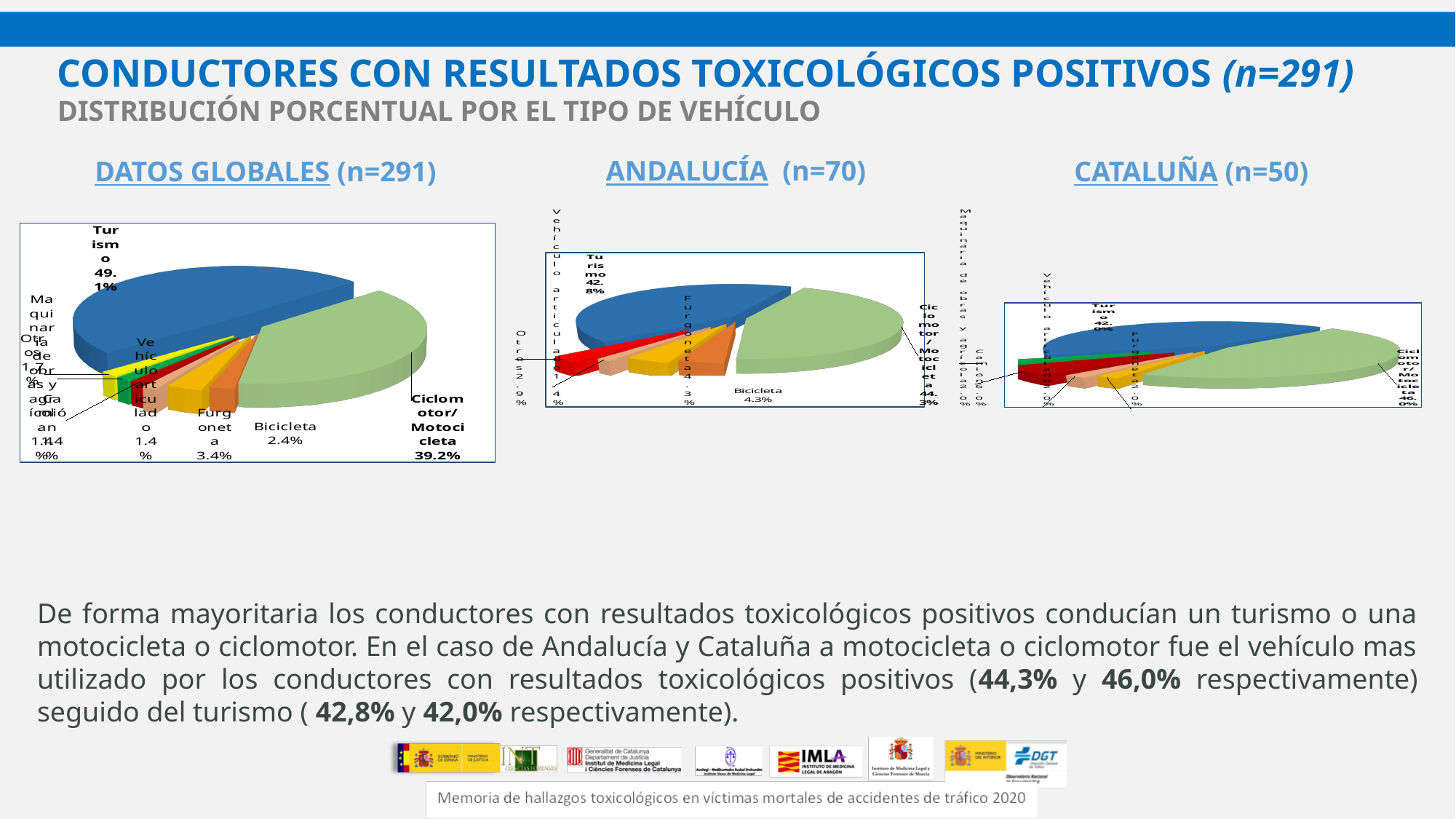
In the Andalucía chart, which is larger, Turismo or Ciclomotor/Motocicleta? Ciclomotor/Motocicleta In the Datos Globales chart, what percentage is shown for Bicicleta? 2.4% In the Andalucía chart, what percentage is shown for Turismo? 42.8% In the Cataluña chart, what percentage is shown for Ciclomotor/Motocicleta? 46.0% In the Datos Globales chart, which vehicle type has the largest share? Turismo In the Andalucía chart, what percentage is shown for Ciclomotor/Motocicleta? 44.3% In the Datos Globales chart, what percentage is shown for Turismo? 49.1% In the Datos Globales chart, what percentage is shown for Ciclomotor/Motocicleta? 39.2% In the Cataluña chart, what percentage is shown for Turismo? 42.0% What kind of chart is used for the Datos Globales data? Pie chart In the Datos Globales chart, what percentage is shown for Furgoneta? 3.4% In the Datos Globales chart, how many percentage points larger is Turismo than Ciclomotor/Motocicleta? 9.9